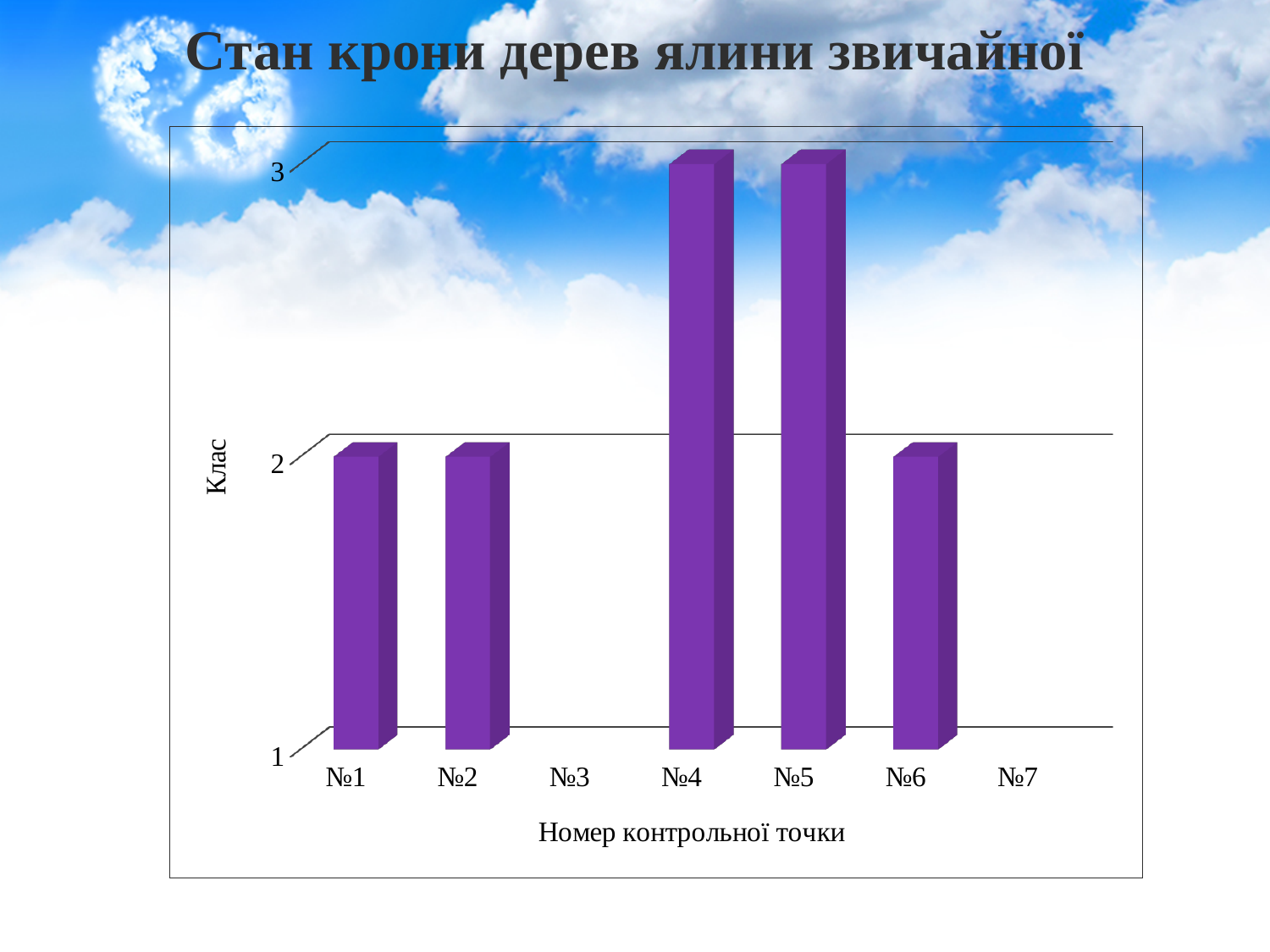
Is the value for control point №5 greater or less than 2? greater Which control points have the highest value on the chart? №4 and №5 Which has a larger value, control point №5 or control point №6? №5 What is the difference between the values for control point №4 and control point №2? 1 What is the value for control point №1? 2 What is the value for control point №4? 3 How many control points are listed on the x axis? 7 What kind of chart is shown on the slide? Bar chart What is the value for control point №5? 3 What is the value for control point №6? 2 Which has a larger value, control point №4 or control point №1? №4 What is the title of the vertical axis? Клас